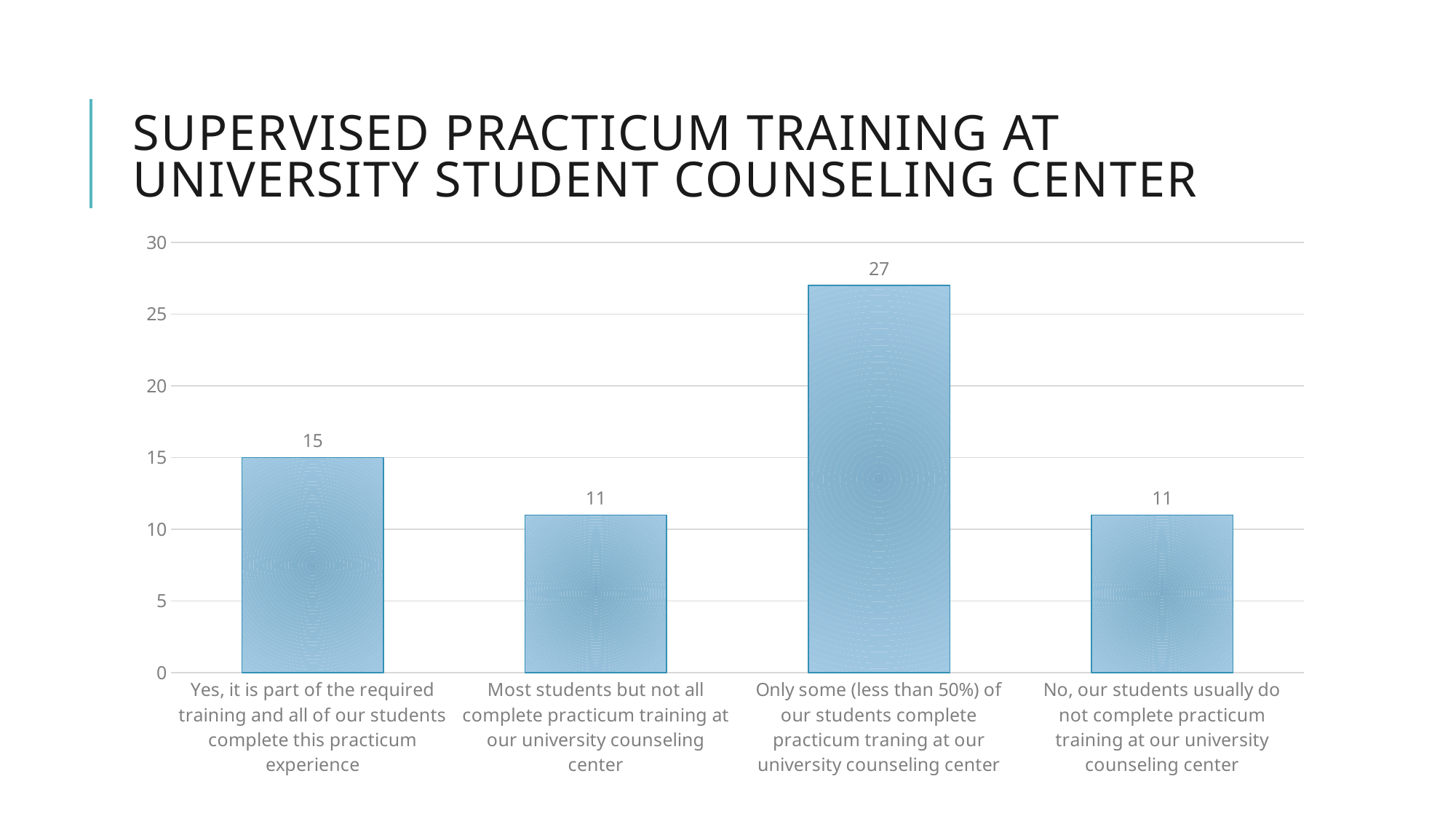
What is the value for the category 'Only some (less than 50%) of our students complete practicum traning at our university counseling center'? 27 What is the difference between the value for 'Only some (less than 50%)' and the value for 'Yes, it is part of the required training'? 12 What is the value for the category 'No, our students usually do not complete practicum training at our university counseling center'? 11 Is the value for 'Only some (less than 50%)' greater or less than 25? greater What is the value for the category 'Yes, it is part of the required training and all of our students complete this practicum experience'? 15 What is the title of the slide? Supervised Practicum Training at University Student Counseling Center What kind of chart is shown on the slide? Bar chart Which category has the highest value? Only some (less than 50%) of our students complete practicum traning at our university counseling center How many categories are shown on the chart? 4 What is the maximum value shown on the vertical axis? 30 What is the difference between the value for 'Yes, it is part of the required training' and the value for 'Most students but not all complete practicum training'? 4 Which is larger: the value for 'Yes, it is part of the required training' or the value for 'No, our students usually do not complete practicum training'? Yes, it is part of the required training